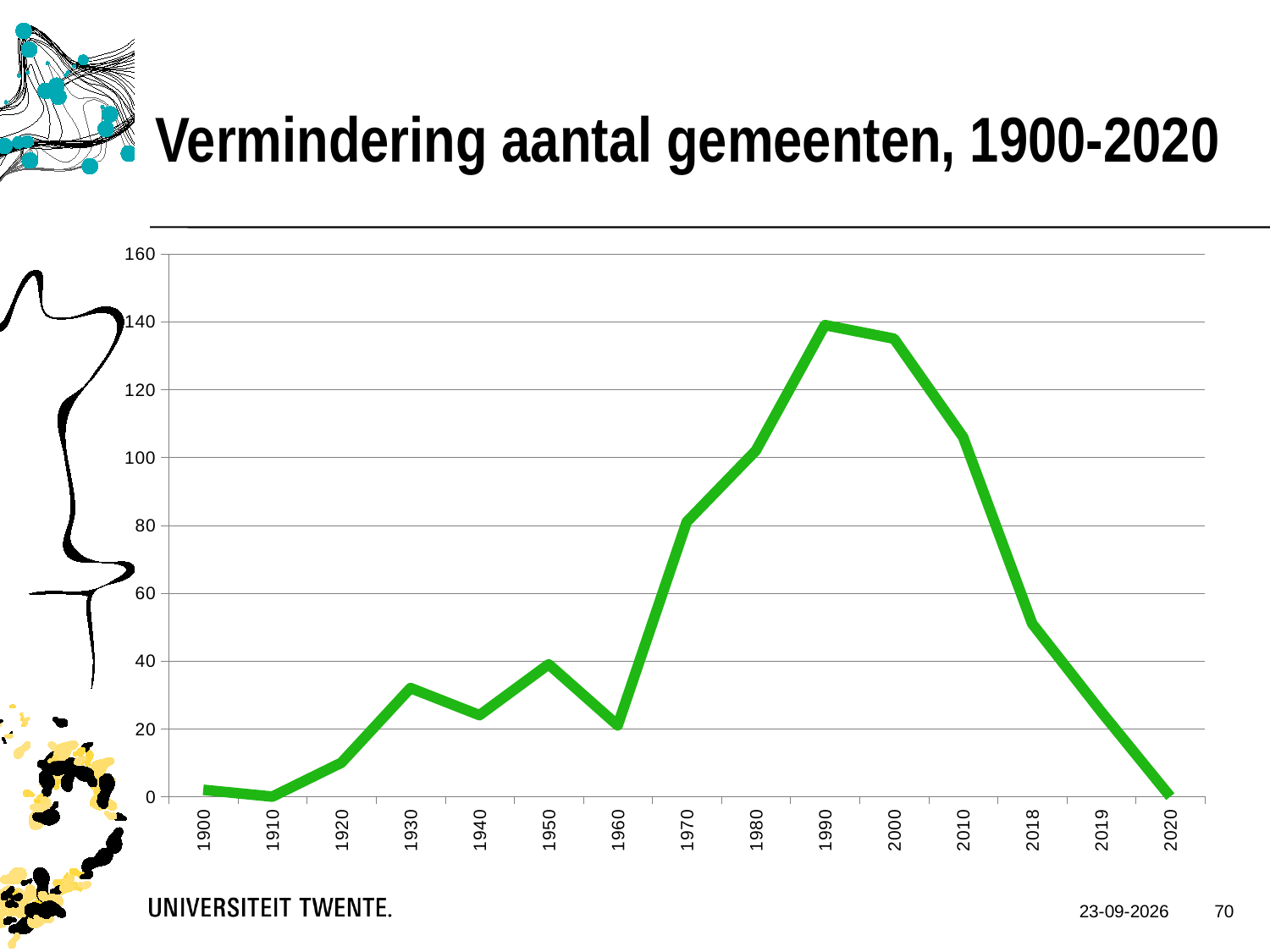
Which year has the larger value, 1940 or 1950? 1950 Do the values rise or fall from 1990 to 2020? fall Is the value for 1970 greater or less than 100? less In which year does the line reach its highest value? 1990 Is the value for 1980 greater or less than 80? greater What kind of chart is shown on the slide? line chart What is the title of the slide's chart? Vermindering aantal gemeenten, 1900-2020 Which year has the larger value, 1930 or 1960? 1930 Is the value for 2010 greater or less than 120? less How many years are labelled on the x axis of the chart? 15